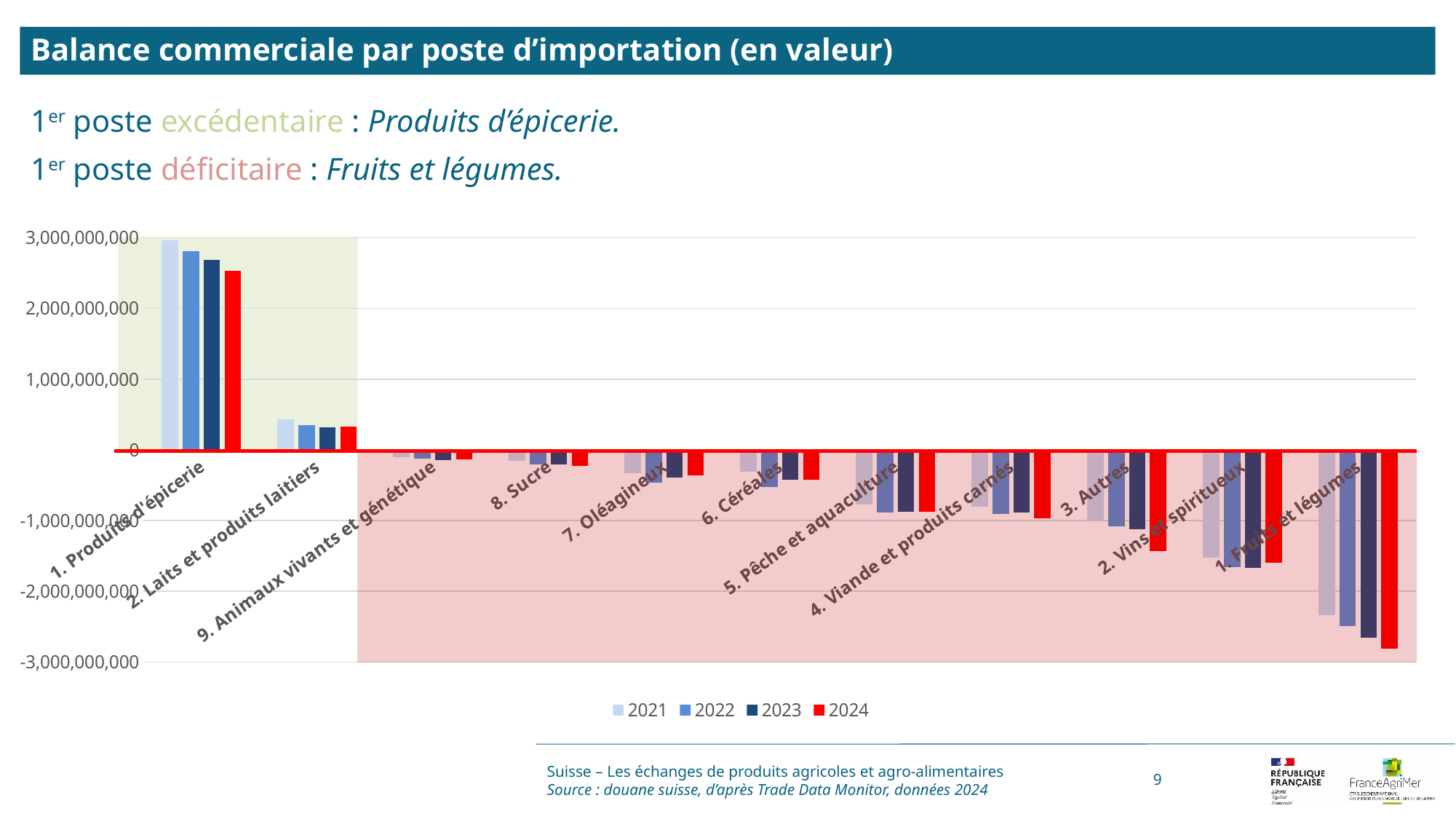
What kind of chart is shown on the slide? bar chart Which category has the highest value in the chart? 1. Produits d'épicerie How many categories are shown on the x axis of the chart? 11 For 1. Produits d'épicerie, do the values rise or fall from 2021 to 2024? fall Is the 2024 value for 1. Produits d'épicerie greater or less than 2,000,000,000? greater What colour represents the 2024 series in the legend? red How many series does the legend list? 4 Which category has the lowest value in the chart? 1. Fruits et légumes Is the 2024 value for 2. Laits et produits laitiers greater or less than 1,000,000,000? less Is the 2024 value for 1. Fruits et légumes greater or less than -2,000,000,000? less Which is larger for 1. Produits d'épicerie: the 2021 value or the 2024 value? 2021